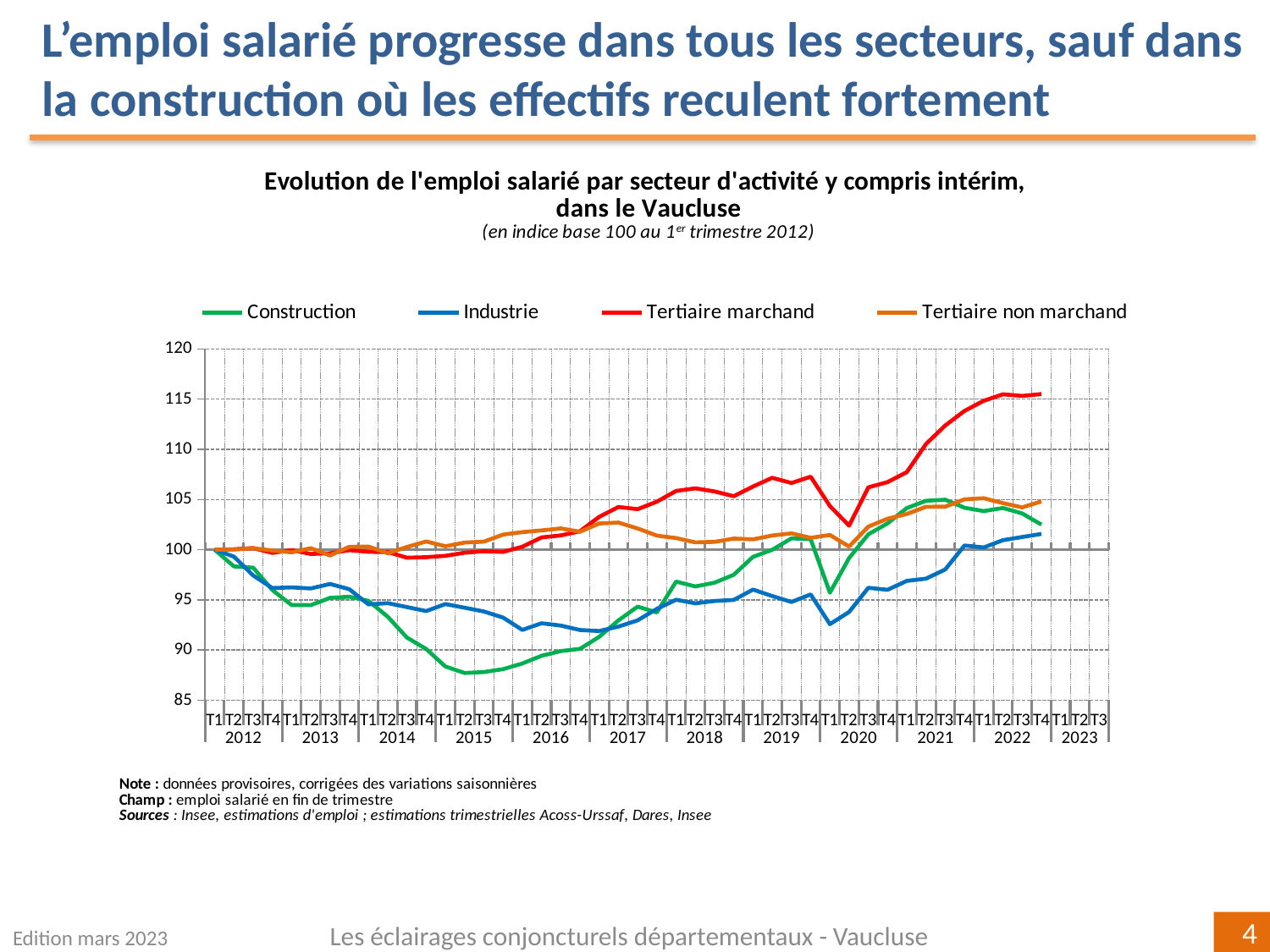
How many series does the legend list? 4 Which series has the lowest value at T2 2015? Construction What is the index value of all four series at T1 2012? 100 Which series has the highest value at T4 2022? Tertiaire marchand What kind of chart is shown on the slide? line chart Is the value for Tertiaire non marchand at T4 2022 greater or less than 100? greater Is the value for Construction at T2 2015 greater or less than 90? less Which is larger at T4 2019: the value for Tertiaire marchand or the value for Industrie? Tertiaire marchand Is the value for Tertiaire marchand at T4 2021 greater or less than 110? greater Which colour is used for the Tertiaire marchand series? red Does the Construction series rise or fall between T1 2012 and T2 2015? fall